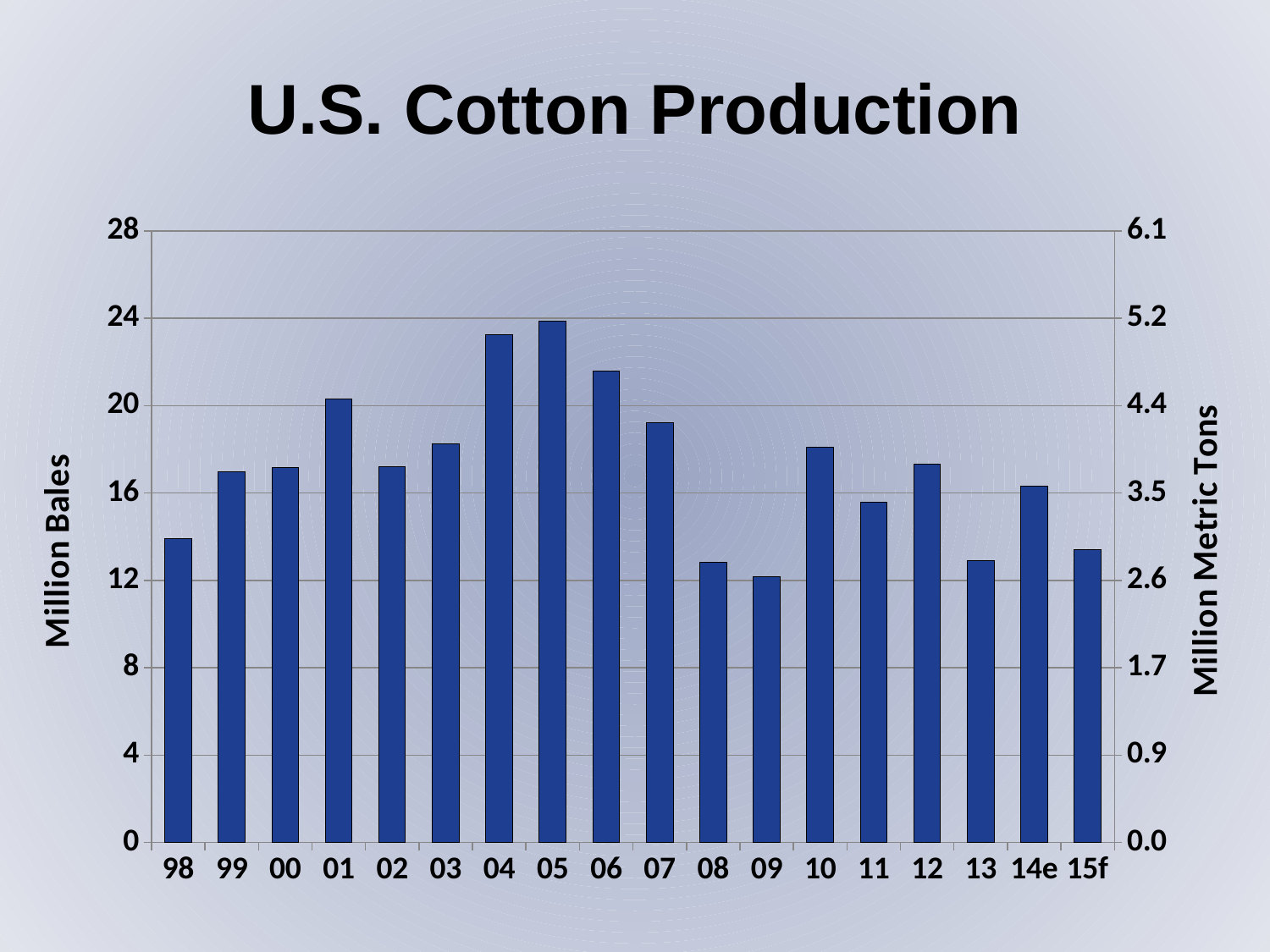
Is the value for 07 greater or less than 20 million bales? less Is the value for 98 greater or less than 16 million bales? less What kind of chart is shown on the slide? bar chart What is the title of the chart? U.S. Cotton Production Which year has the highest cotton production? 05 Which year has the larger production, 04 or 06? 04 How many years (bars) are shown on the chart? 18 Is the value for 06 greater or less than 20 million bales? greater Which year has the lowest cotton production? 09 What is the label of the left vertical axis? Million Bales Do the values rise or fall from 05 to 09? fall